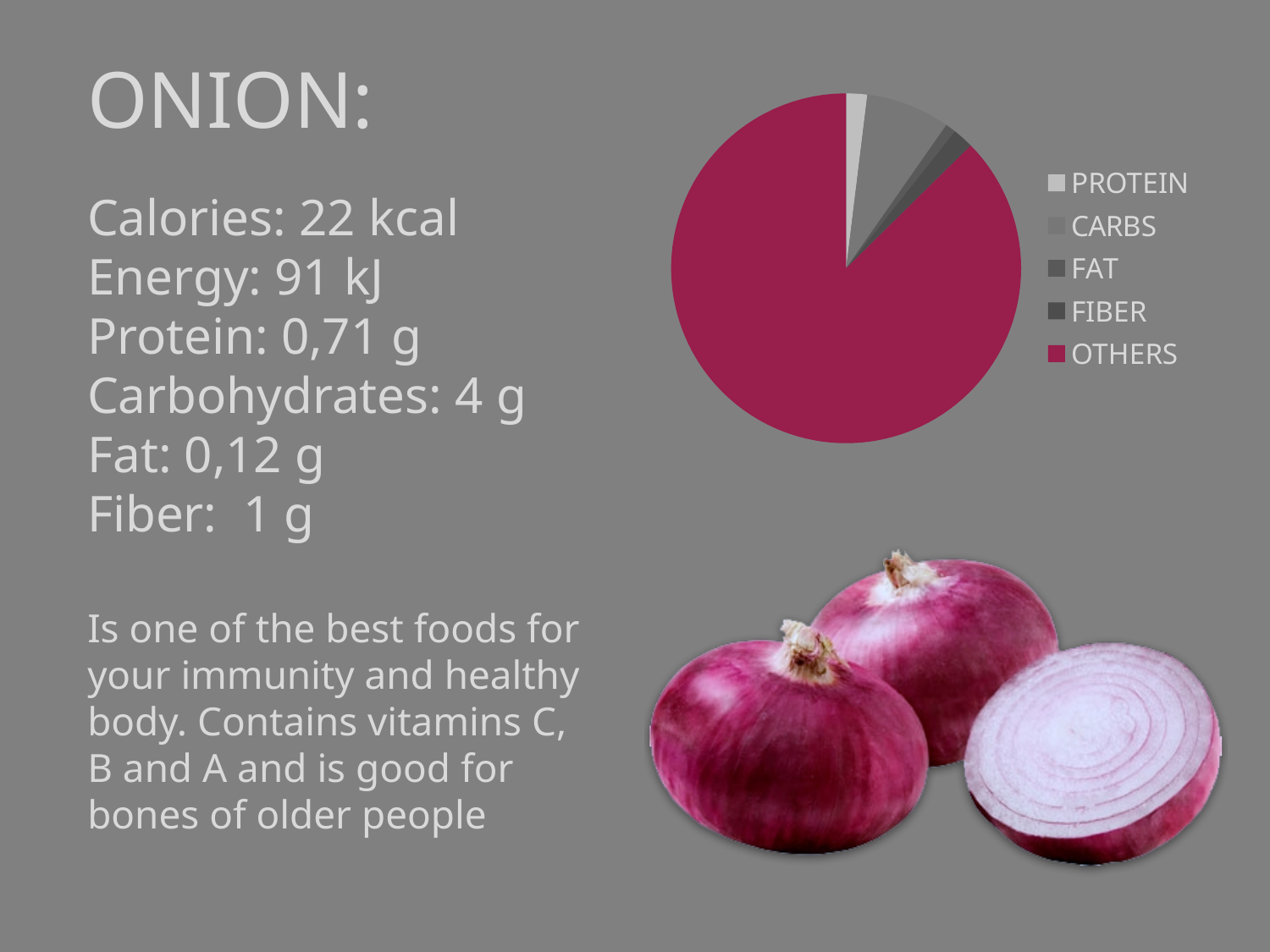
What colour is the OTHERS slice in the pie chart? magenta Does the OTHERS slice take up more or less than half of the pie chart? more How many slices does the pie chart have? 5 Which category is listed last in the pie chart's legend? OTHERS What kind of chart is shown on the slide? pie chart Which slice is larger in the pie chart, OTHERS or CARBS? OTHERS How many categories does the legend of the pie chart list? 5 Which category has the largest slice in the pie chart? OTHERS Which slice is larger in the pie chart, CARBS or PROTEIN? CARBS